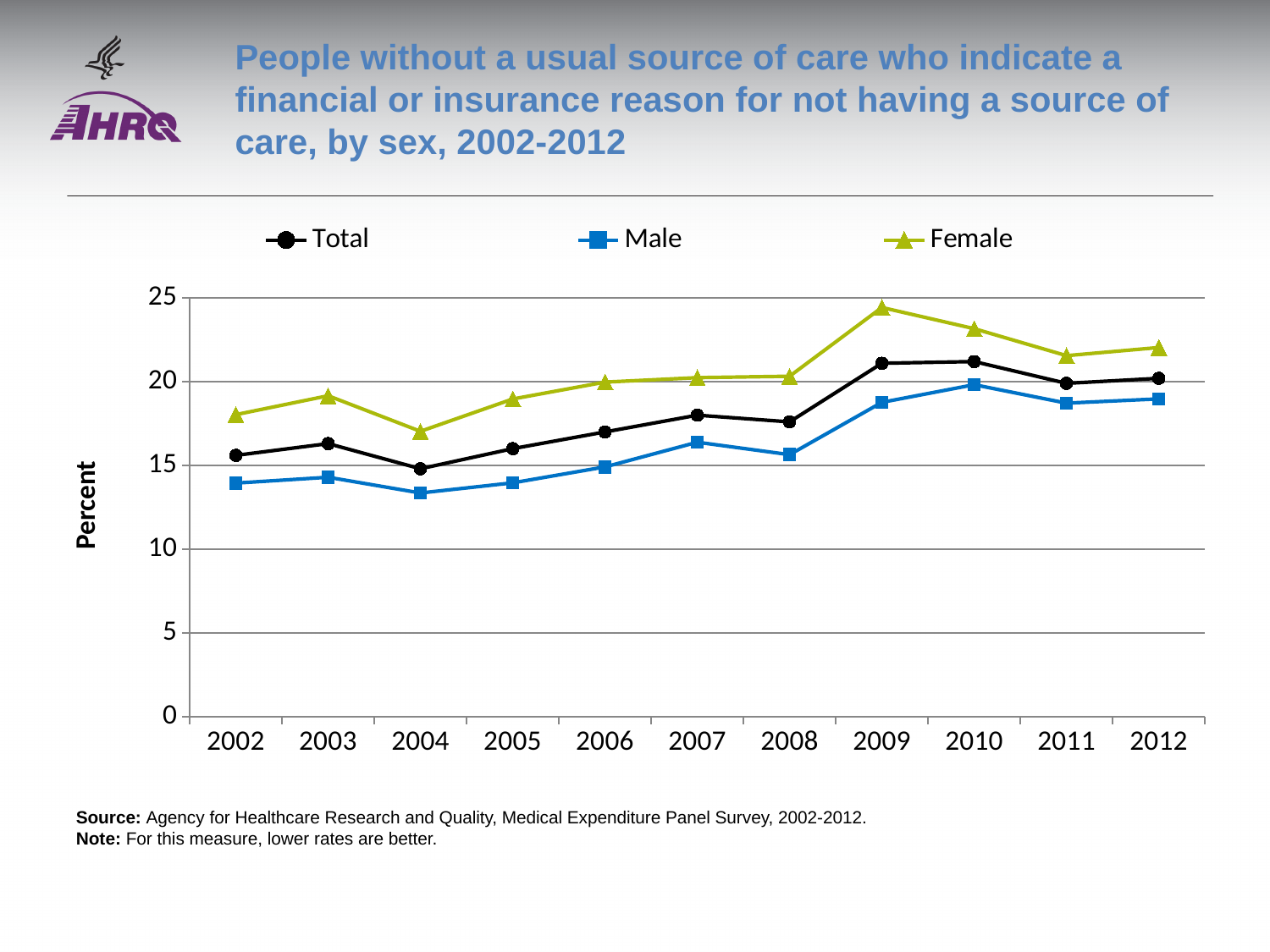
How many years are plotted along the x axis? 11 Does the Female series rise or fall from 2009 to 2011? fall How many series does the legend list? 3 In which year does the Male series reach its lowest value? 2004 In which year does the Female series reach its highest value? 2009 What is the label on the y axis? Percent Is the value for Female in 2009 greater or less than 20? greater What kind of chart is shown on the slide? line chart Is the value for Male in 2004 greater or less than 15? less Which series has the higher value in 2009, Male or Female? Female Is the value for Total in 2010 greater or less than 20? greater For the Total series, which year has the larger value, 2004 or 2009? 2009